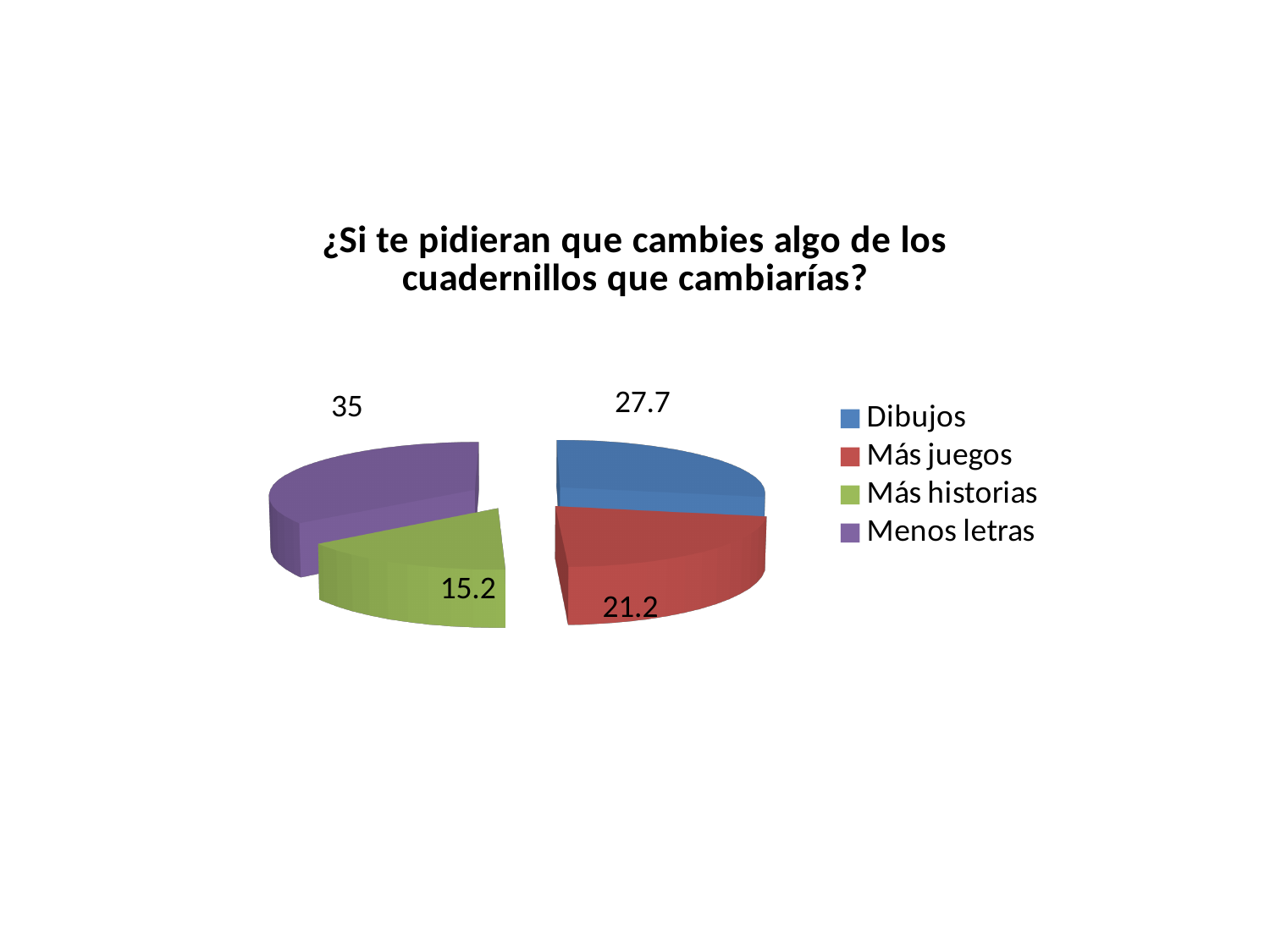
What is the difference between the values for Menos letras and Dibujos? 7.3 How many categories does the pie chart have? 4 What is the value for Más juegos? 21.2 What is the value for Más historias? 15.2 What is the value for Menos letras? 35 Which is larger, the value for Dibujos or the value for Más juegos? Dibujos What colour is the slice for Menos letras? Purple What type of chart is shown on the slide? Pie chart Which category has the smallest slice? Más historias What is the value for Dibujos? 27.7 What is the difference between the values for Más juegos and Más historias? 6 Which category has the largest slice? Menos letras